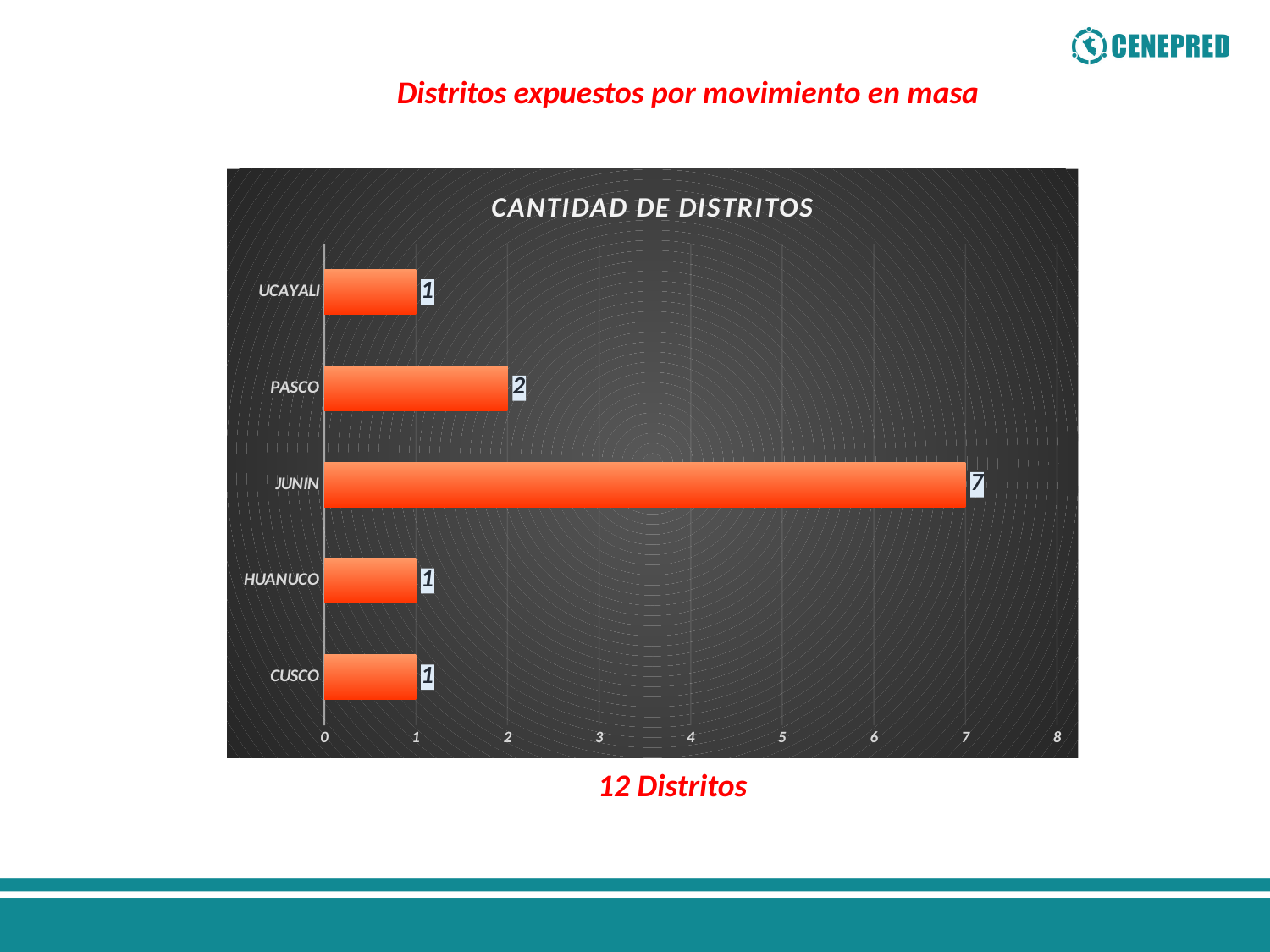
How many categories are shown in the chart? 5 What is the highest value shown on the x axis? 8 What is the value for PASCO? 2 What is the value for UCAYALI? 1 Which category has the highest value? JUNIN Is the value for JUNIN greater or less than 6? greater What kind of chart is shown? bar chart Which is larger, the value for PASCO or the value for CUSCO? PASCO What is the value for HUANUCO? 1 What is the value for JUNIN? 7 What is the difference between the values for JUNIN and PASCO? 5 What is the title of the chart? CANTIDAD DE DISTRITOS